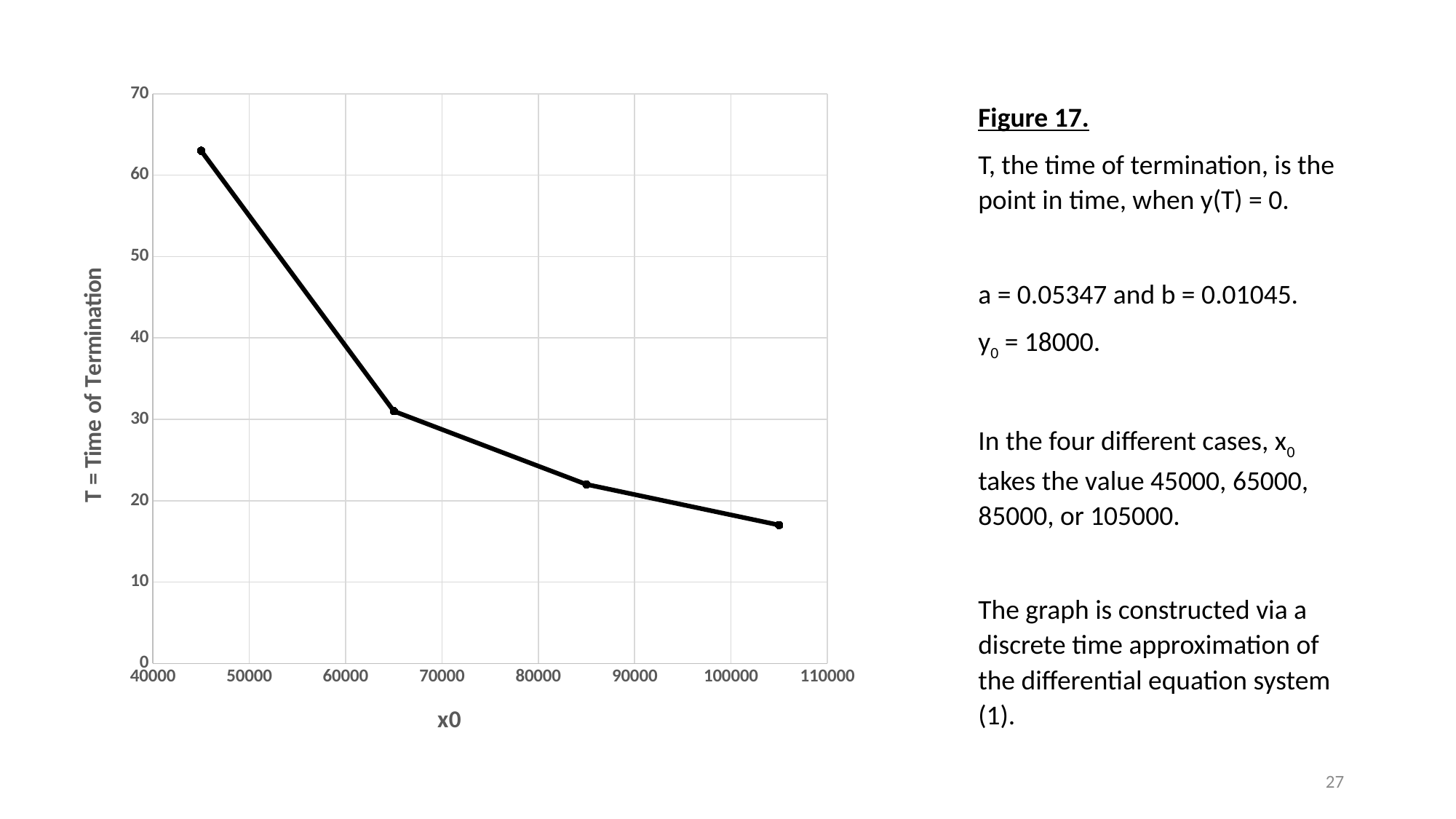
Which has a larger time of termination, x0 = 85000 or x0 = 105000? 85000 Does T, the time of termination, rise or fall as x0 increases? fall What is the label of the vertical axis of the chart? T = Time of Termination How many data points are plotted on the line? 4 What kind of chart is shown on the slide? line chart Is the time of termination for x0 = 85000 greater or less than 30? less Which has a larger time of termination, x0 = 45000 or x0 = 65000? 45000 Is the time of termination for x0 = 45000 greater or less than 60? greater Is the time of termination for x0 = 105000 greater or less than 20? less At which x0 value is the time of termination lowest? 105000 At which x0 value is the time of termination highest? 45000